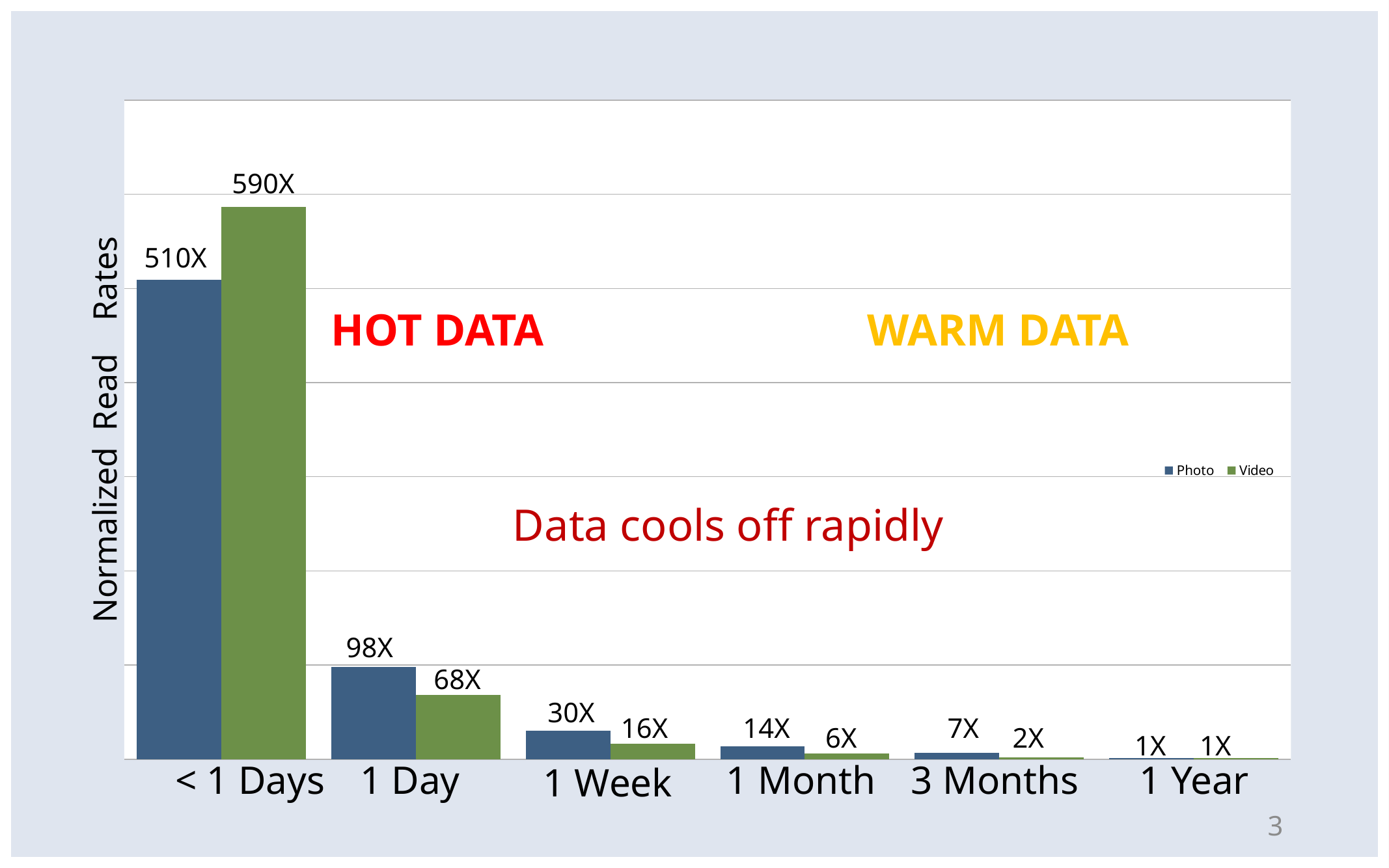
What kind of chart is shown on the slide? Bar chart How many categories are shown on the x axis? 6 What is the difference between the Video and Photo values for '< 1 Days'? 80X How many series does the legend list? 2 Which is larger for '1 Month': the Photo value or the Video value? Photo What is the Video value for the '1 Day' category? 68X Which category has the highest Video value? < 1 Days What is the Photo value for the '< 1 Days' category? 510X What is the label on the y axis? Normalized Read Rates Which category has the lowest Photo value? 1 Year Do the Photo values rise or fall from '< 1 Days' to '1 Year'? Fall What is the Photo value for '1 Week'? 30X